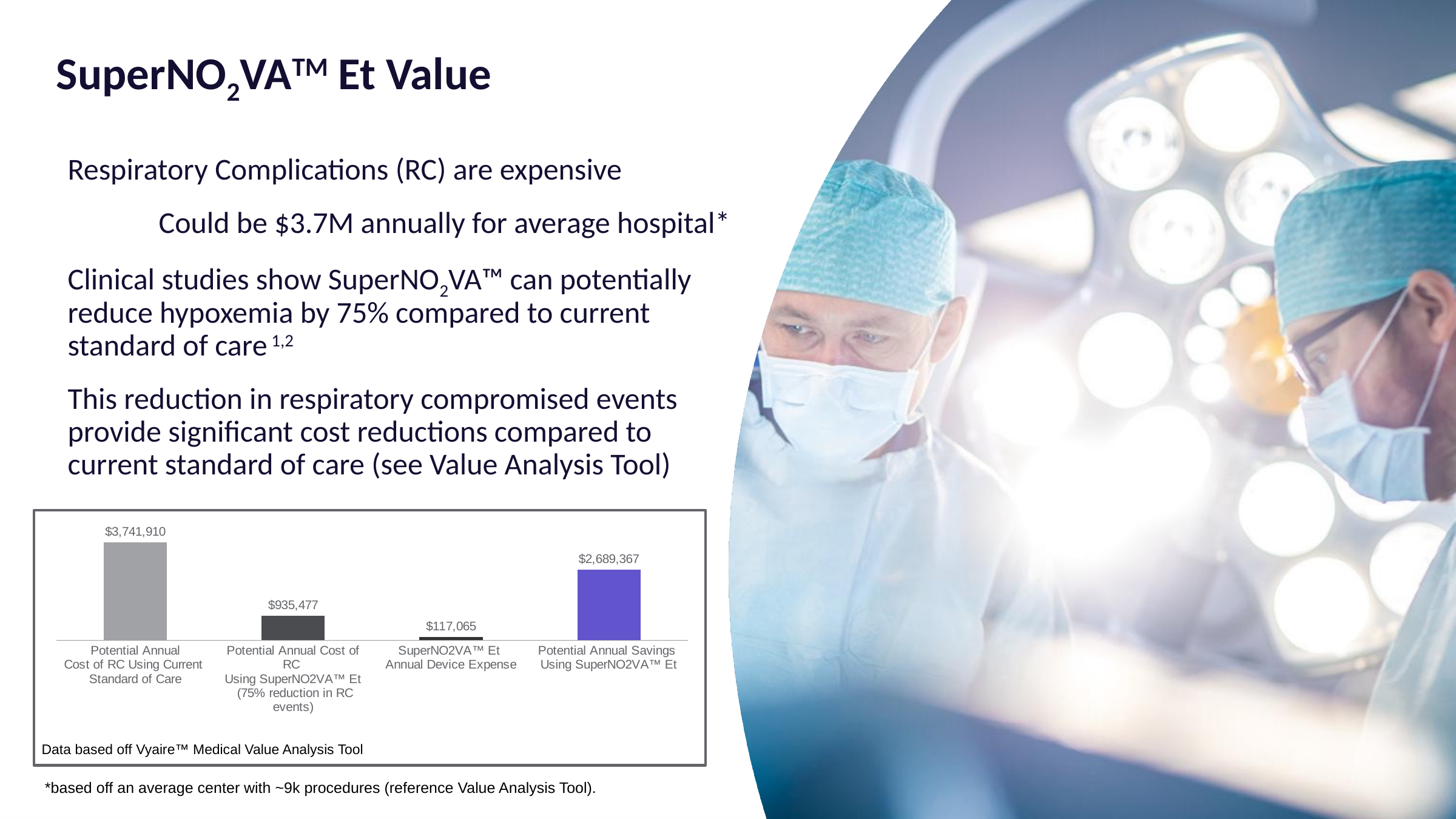
Which is larger: the Potential Annual Cost of RC Using SuperNO2VA™ Et or the Potential Annual Savings Using SuperNO2VA™ Et? Potential Annual Savings Using SuperNO2VA™ Et What is the difference between the Potential Annual Cost of RC Using Current Standard of Care and the Potential Annual Cost of RC Using SuperNO2VA™ Et? $2,806,433 What is the value shown for SuperNO2VA™ Et Annual Device Expense? $117,065 What is the value shown for Potential Annual Cost of RC Using SuperNO2VA™ Et (75% reduction in RC events)? $935,477 What is the difference between the Potential Annual Savings Using SuperNO2VA™ Et and the SuperNO2VA™ Et Annual Device Expense? $2,572,302 Which category has the lowest value in the chart? SuperNO2VA™ Et Annual Device Expense What is the value shown for Potential Annual Cost of RC Using Current Standard of Care? $3,741,910 How many categories are shown in the chart? 4 What kind of chart is shown on the slide? Bar chart Which category has the highest value in the chart? Potential Annual Cost of RC Using Current Standard of Care What is the value shown for Potential Annual Savings Using SuperNO2VA™ Et? $2,689,367 What colour is the bar for Potential Annual Savings Using SuperNO2VA™ Et? Purple